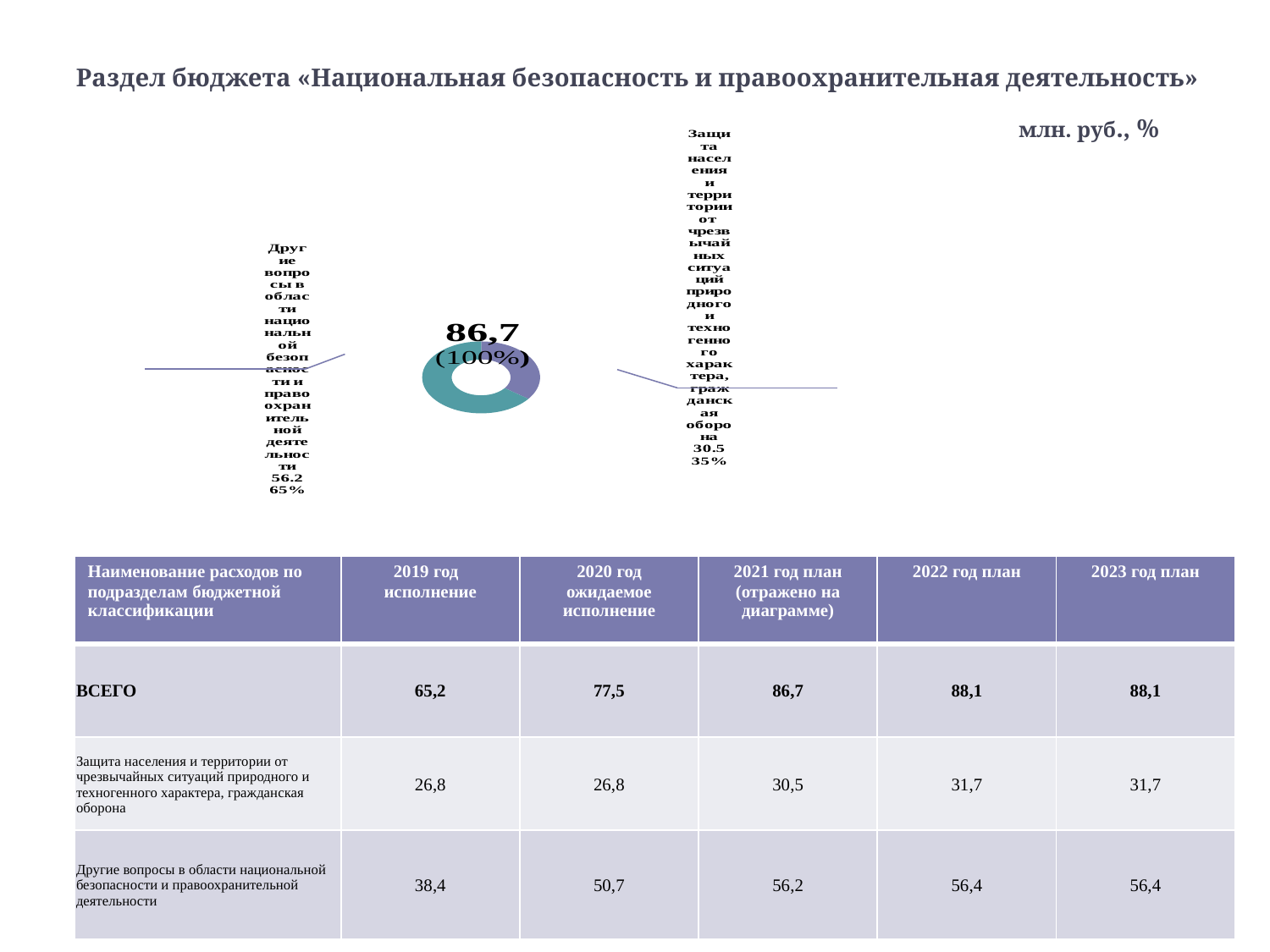
Which is larger: the slice for "Другие вопросы..." or the slice for "Защита населения..."? Другие вопросы в области национальной безопасности и правоохранительной деятельности How many slices does the doughnut chart have? 2 What value is shown for the slice "Другие вопросы в области национальной безопасности и правоохранительной деятельности"? 56.2 What total value is shown in the centre of the doughnut chart? 86,7 (100%) Which slice of the doughnut chart is the smallest? Защита населения и территории от чрезвычайных ситуаций природного и техногенного характера, гражданская оборона What is the difference between the values of the two slices (56.2 and 30.5)? 25.7 What unit is indicated for the chart on the slide? млн. руб., % What percentage share does the slice "Защита населения и территории от чрезвычайных ситуаций природного и техногенного характера, гражданская оборона" have? 35% What percentage share does the slice "Другие вопросы в области национальной безопасности и правоохранительной деятельности" have? 65% Which slice of the doughnut chart is the largest? Другие вопросы в области национальной безопасности и правоохранительной деятельности What value is shown for the slice "Защита населения и территории от чрезвычайных ситуаций природного и техногенного характера, гражданская оборона"? 30.5 What kind of chart is shown on the slide? Doughnut chart